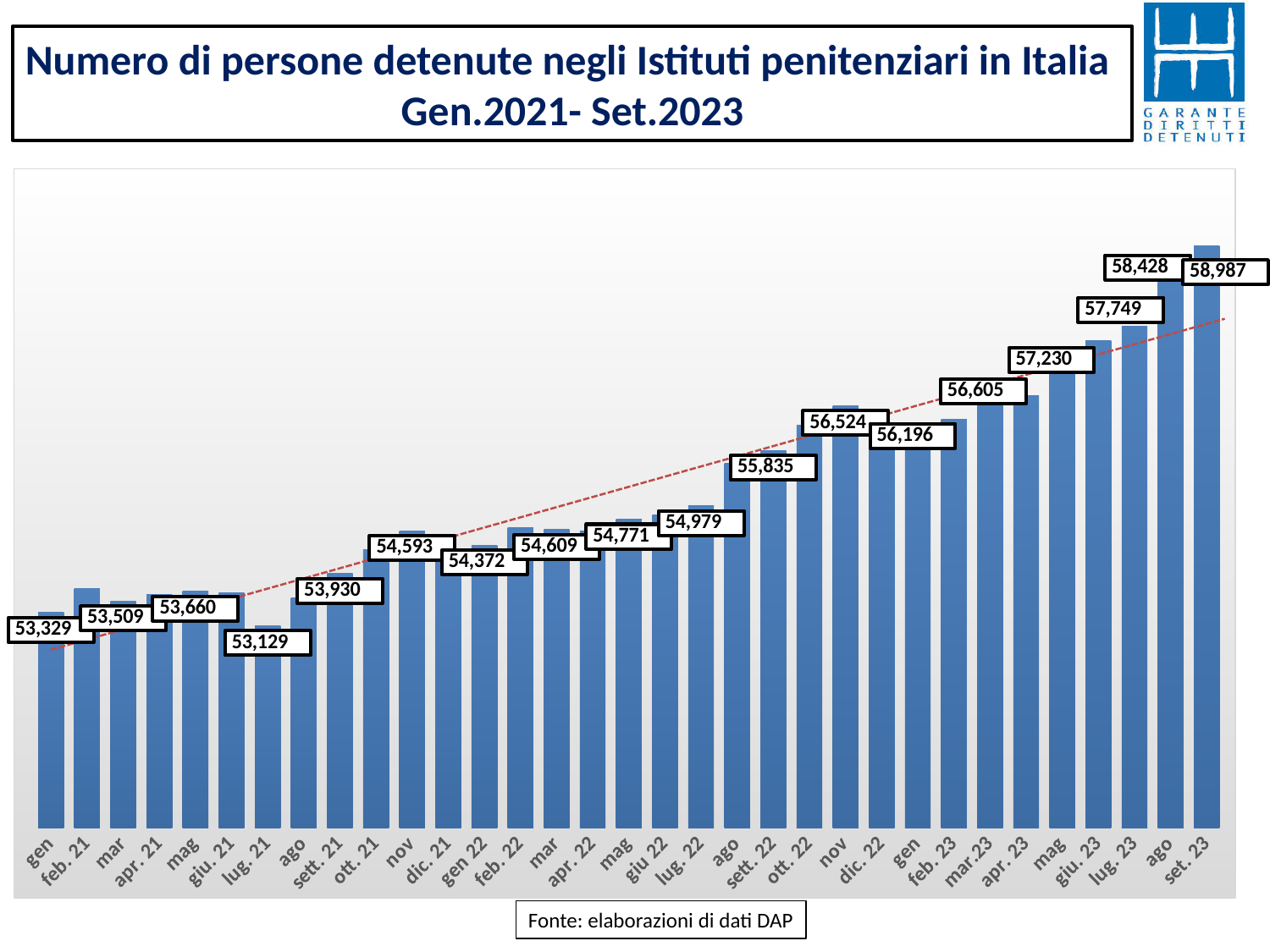
Which month has the highest number of detained persons? set. 23 What is the difference between the value for set. 23 (58,987) and the value for gen 21 (53,329)? 5,658 Which month has the lowest bar in the chart? lug. 21 Overall, do the values rise or fall from gen 21 to set. 23? rise What is the difference between the labelled values for set. 23 (58,987) and ago 23 (58,428)? 559 What is the number of detained persons shown for gen 21 (January 2021), the first bar? 53,329 What value is labelled for lug. 21 (July 2021)? 53,129 What value is labelled for ago 23 (August 2023)? 58,428 What kind of chart is shown on the slide? bar chart What is the number of detained persons shown for set. 23 (September 2023), the last bar? 58,987 Which is larger, the value for set. 23 or the value for gen 21? set. 23 How many monthly bars are plotted in the chart? 33